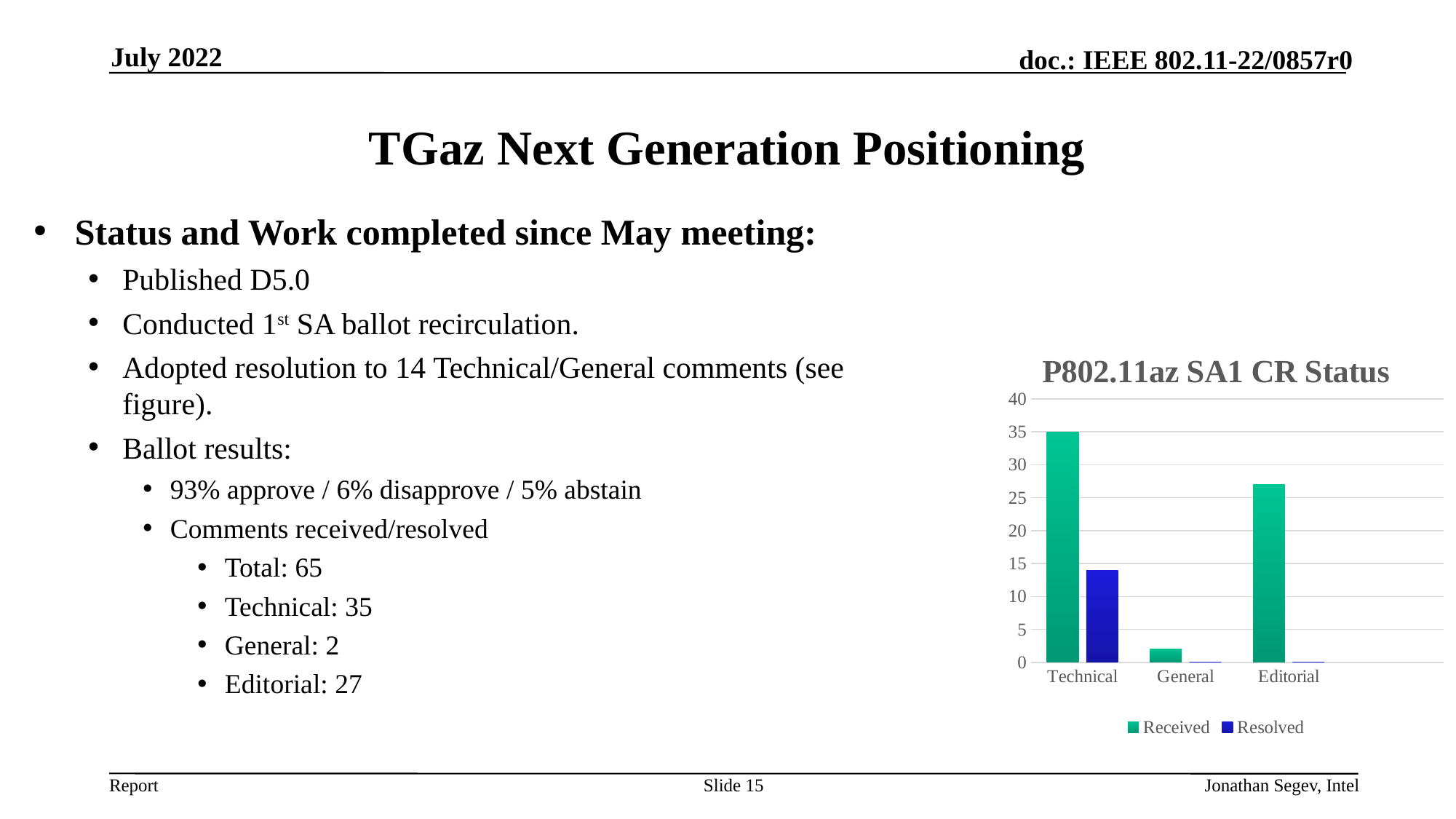
In the P802.11az SA1 CR Status chart, is the Received value for General greater or less than 5? less How many series does the legend of the P802.11az SA1 CR Status chart list? 2 What kind of chart is the P802.11az SA1 CR Status chart? bar chart In the P802.11az SA1 CR Status chart, which series is shown in blue? Resolved In the P802.11az SA1 CR Status chart, what is the Received value for Technical? 35 In the P802.11az SA1 CR Status chart, is the Received value for Editorial greater or less than 25? greater What is the title of the chart on the slide? P802.11az SA1 CR Status In the P802.11az SA1 CR Status chart, which is larger: the Received value for Technical or the Received value for Editorial? Technical How many categories are shown on the x axis of the P802.11az SA1 CR Status chart? 3 In the P802.11az SA1 CR Status chart, is the Resolved value for Technical greater or less than 10? greater In the P802.11az SA1 CR Status chart, which category has the lowest Received value? General In the P802.11az SA1 CR Status chart, which category has the highest Received value? Technical